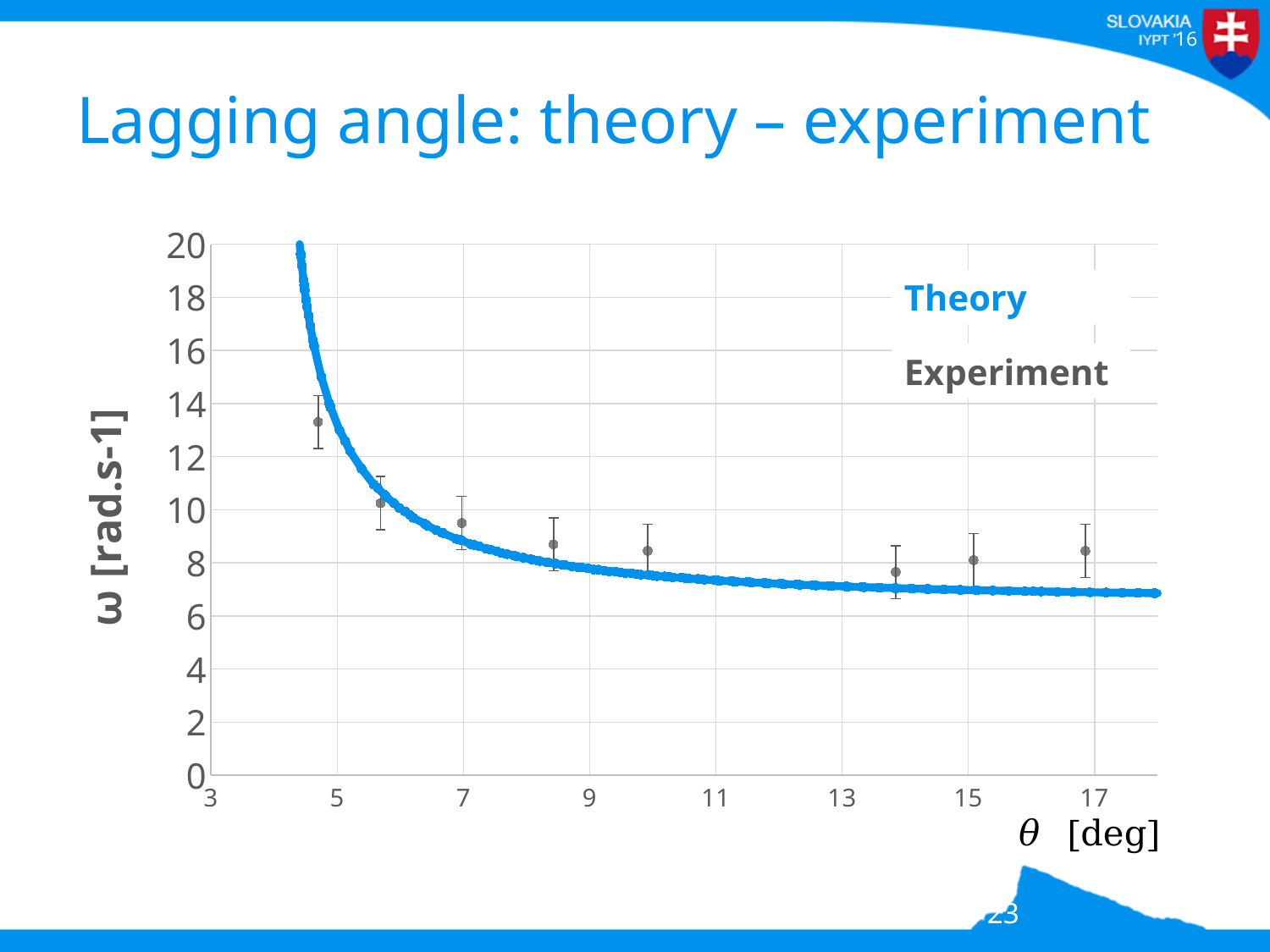
What is the label of the y axis? ω [rad.s-1] Is the Experiment value at θ near 7 deg greater or less than 8? greater Is the Experiment value at the leftmost point (θ near 5 deg) greater or less than 12? greater Is the Theory curve value at θ = 17 deg greater or less than 8? less Which is larger: the Experiment value at θ near 5 deg or at θ near 10 deg? θ near 5 deg Does the Theory curve rise or fall as θ increases? fall What are the two series named in the legend? Theory and Experiment How many Experiment data points are plotted? 8 Which Experiment point has the highest ω value? the leftmost point, at θ near 5 deg How many series does the legend list? 2 What kind of chart is shown on the slide? line chart with scatter points